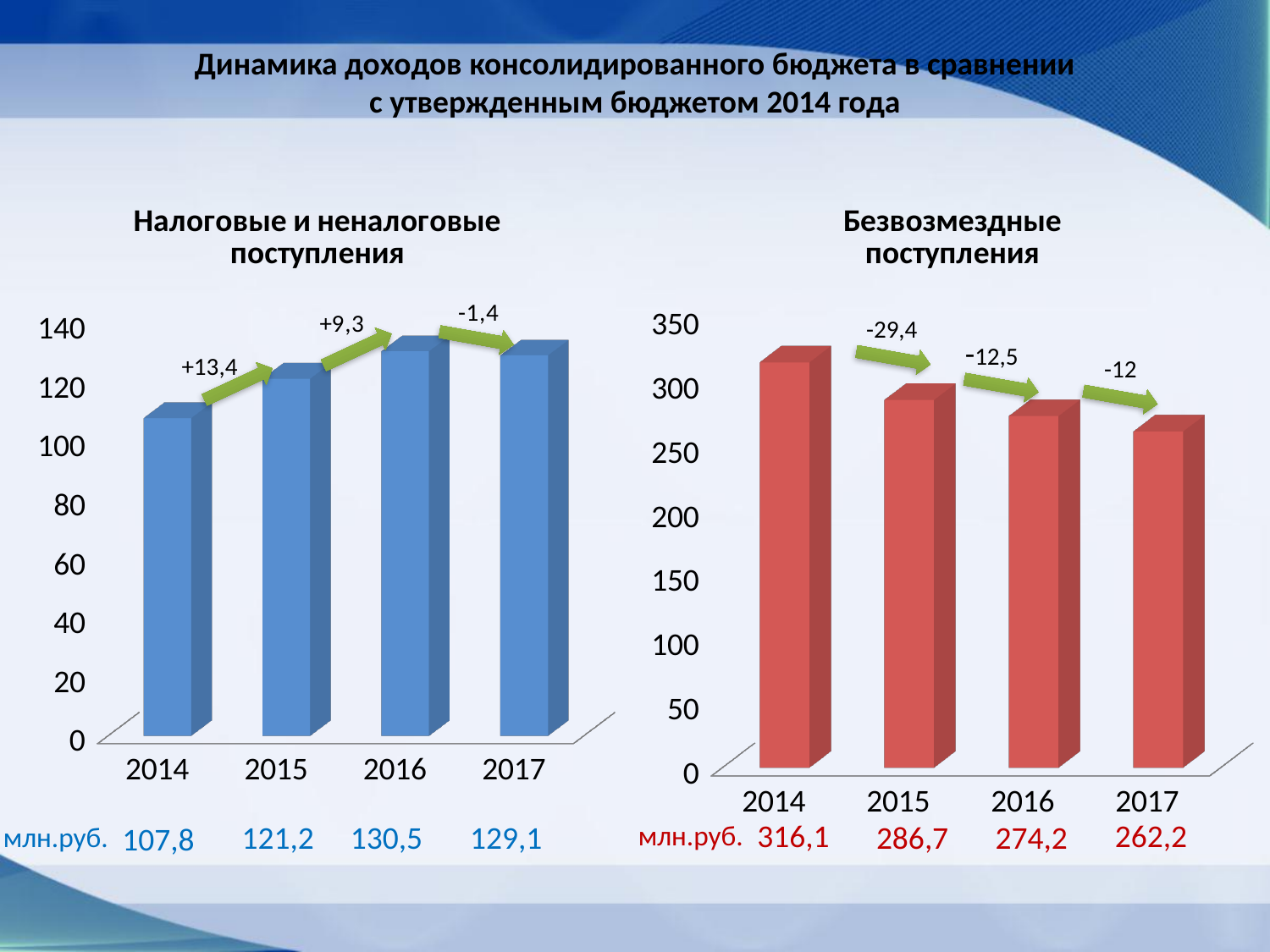
What kind of chart is the chart titled "Безвозмездные поступления"? bar chart In the chart titled "Безвозмездные поступления", is the value for 2016 greater or less than 300? less In the chart titled "Безвозмездные поступления", do the values rise or fall from 2014 to 2017? fall In the chart titled "Безвозмездные поступления", which year has the lowest value? 2017 In the chart titled "Налоговые и неналоговые поступления", what is the value for 2016? 130,5 In the chart titled "Налоговые и неналоговые поступления", which year has the highest value? 2016 In the chart titled "Безвозмездные поступления", what is the difference between the values for 2014 and 2015? 29,4 In the chart titled "Налоговые и неналоговые поступления", what is the value for 2014? 107,8 In the chart titled "Безвозмездные поступления", what is the value for 2017? 262,2 How many years are shown on the x axis of the chart titled "Налоговые и неналоговые поступления"? 4 In the chart titled "Безвозмездные поступления", what is the value for 2015? 286,7 In the chart titled "Налоговые и неналоговые поступления", which is larger, the value for 2015 or the value for 2017? 2017